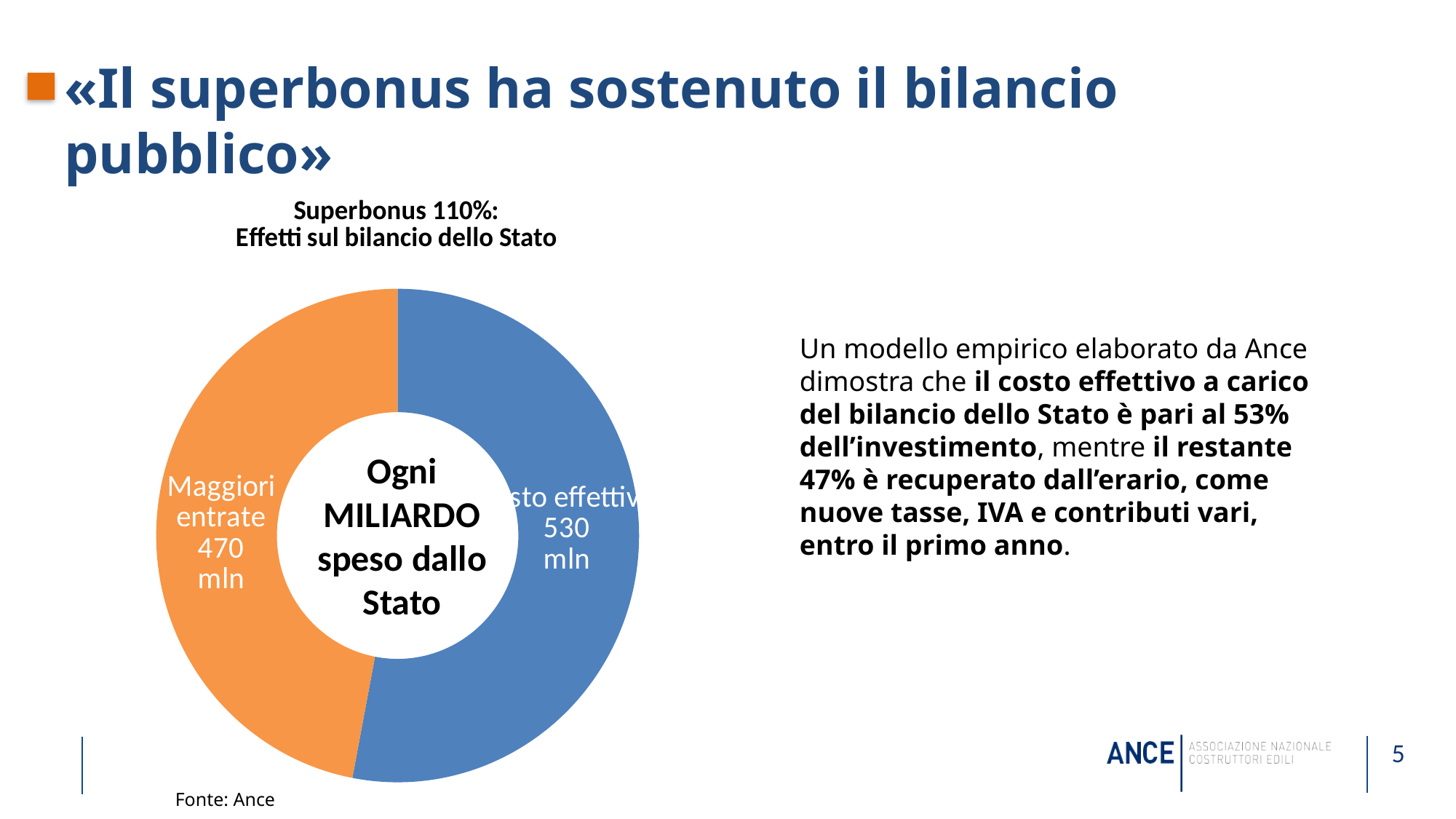
What is the difference between the "Costo effettivo" value and the "Maggiori entrate" value? 60 mln What is the value shown for "Costo effettivo" in the doughnut chart? 530 mln Which slice of the doughnut chart is the largest? Costo effettivo How many slices does the doughnut chart have? 2 What colour is the "Maggiori entrate" slice in the doughnut chart? Orange What kind of chart is shown on the slide? Doughnut (pie) chart Which slice of the doughnut chart is the smallest? Maggiori entrate What is the total of the two values in the doughnut chart? 1,000 mln What share of the doughnut chart does "Costo effettivo" represent? 53% What is the title of the doughnut chart? Superbonus 110%: Effetti sul bilancio dello Stato Which is larger, "Maggiori entrate" or "Costo effettivo"? Costo effettivo What is the value shown for "Maggiori entrate" in the doughnut chart? 470 mln